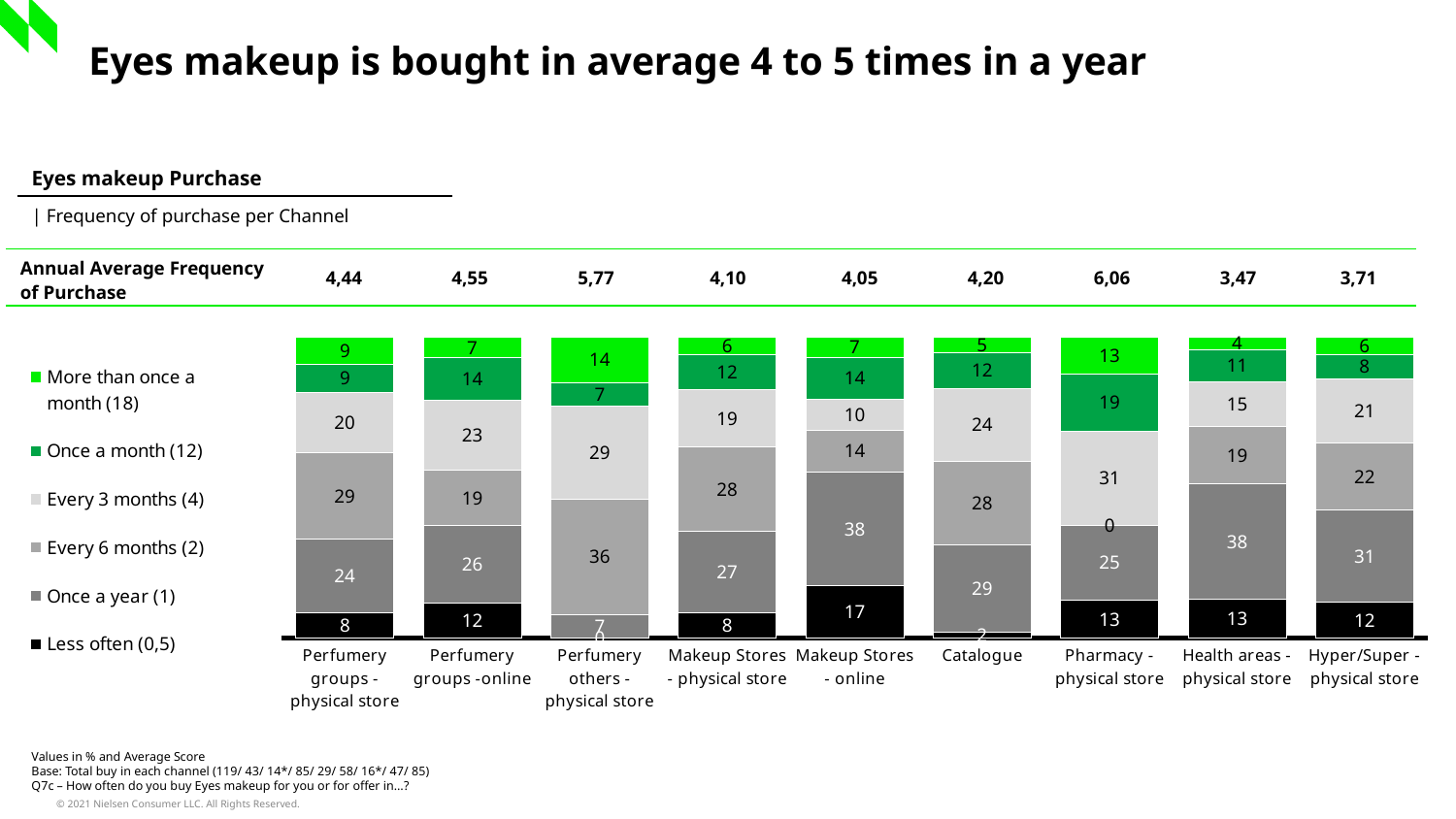
What kind of chart is shown on the slide? Stacked bar chart What is the difference between the 'Once a year (1)' values for Health areas - physical store and Perfumery groups - physical store? 14 What is the 'Every 6 months (2)' value for Pharmacy - physical store? 0 What is the 'Less often (0,5)' value for Makeup Stores - online? 17 Which channel has the lowest 'Less often (0,5)' value? Perfumery others - physical store Which channel has the highest 'More than once a month (18)' value? Perfumery others - physical store What is the 'Every 3 months (4)' value for Pharmacy - physical store? 31 Which has the larger 'Every 6 months (2)' value: Perfumery others - physical store or Catalogue? Perfumery others - physical store What is the 'Once a year (1)' value for Makeup Stores - online? 38 How many series does the legend list? 6 How many channels are shown along the x axis of the chart? 9 What is the Annual Average Frequency of Purchase shown for Pharmacy - physical store? 6,06